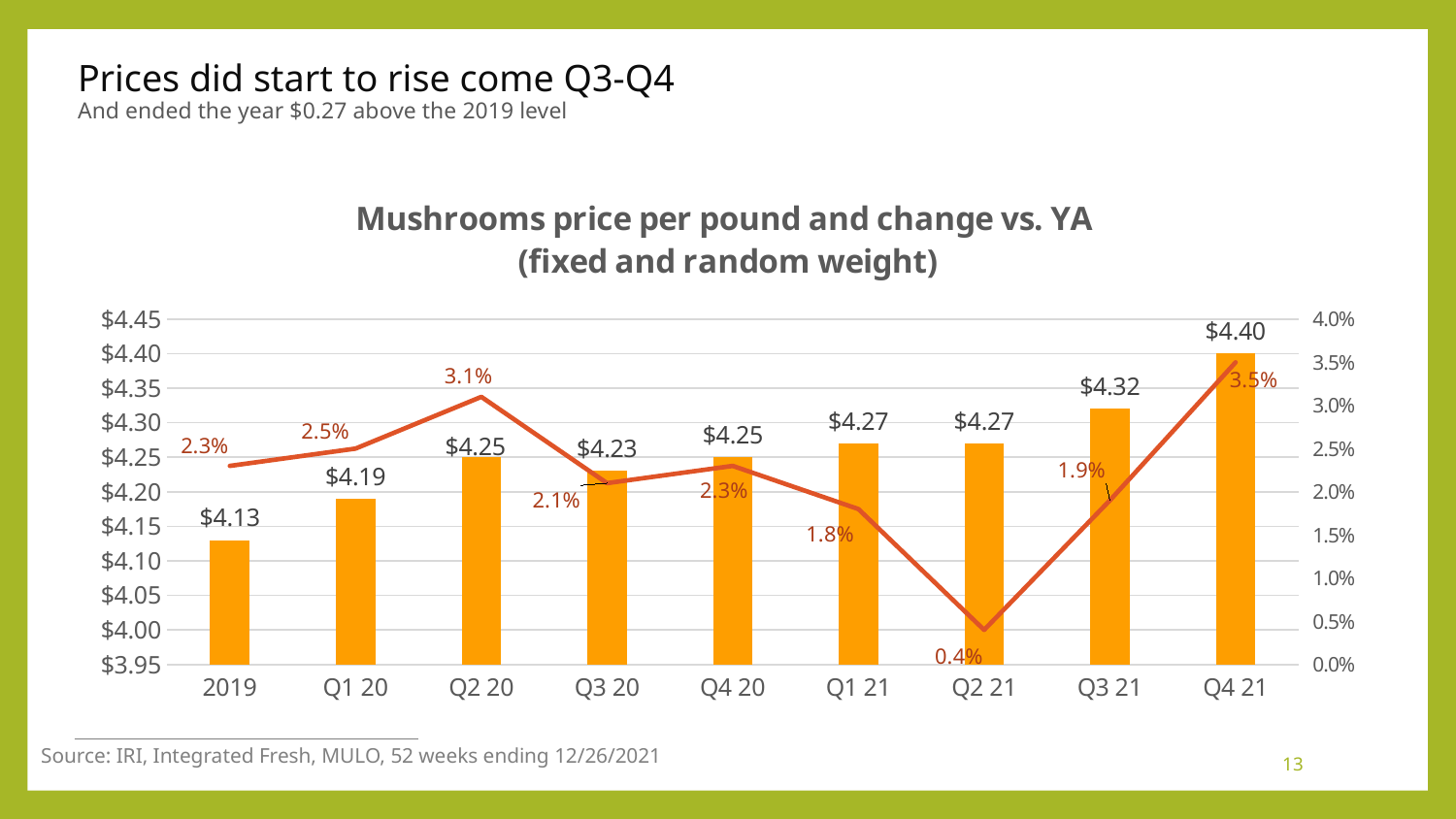
What kind of chart is this? Combined bar and line chart What is the mushroom price per pound shown for Q4 21? $4.40 What is the change vs. YA shown for Q2 20? 3.1% How many periods are shown on the x axis? 9 What is the price per pound shown for 2019? $4.13 Which period has the lowest change vs. YA? Q2 21 Which period has the highest price per pound? Q4 21 What is the difference in price per pound between Q4 21 and 2019? $0.27 What is the change vs. YA shown for Q2 21? 0.4% What is the difference in price per pound between Q3 21 and Q3 20? $0.09 What is the title of the chart? Mushrooms price per pound and change vs. YA (fixed and random weight) Which is larger, the change vs. YA for Q1 21 or for Q3 21? Q3 21